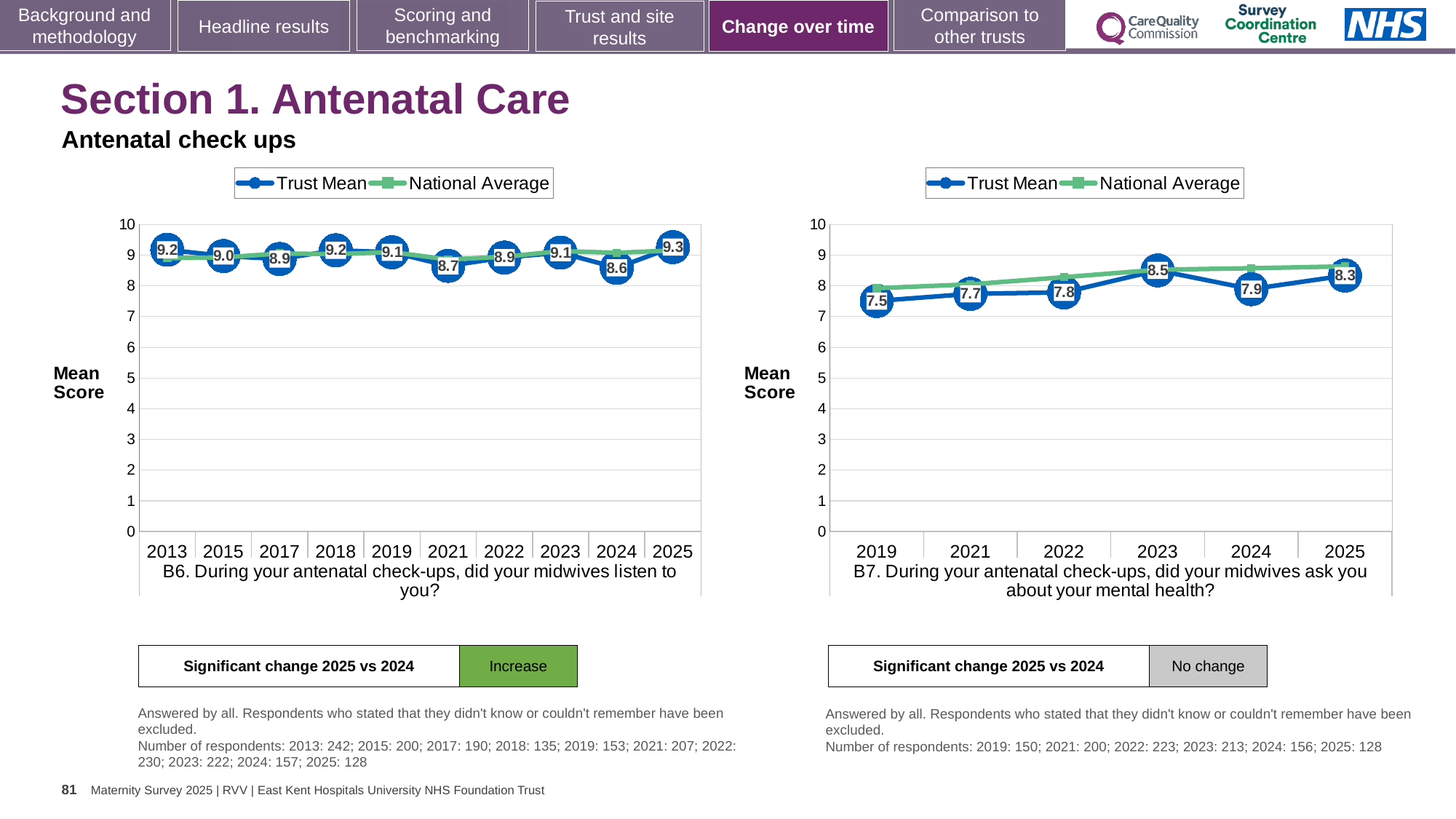
In the B6 chart (left), what is the difference between the Trust Mean in 2025 and in 2024? 0.7 In the B6 chart (left), which year has the lowest Trust Mean? 2024 In the B6 chart (left), how many years are shown on the x axis? 10 How many series does the legend of the B7 chart (right) list? 2 In the B7 chart (right), is the Trust Mean for 2019 greater or less than 8? less In the B6 chart (left), what is the Trust Mean for 2024? 8.6 In the B7 chart (right), is the Trust Mean higher in 2023 or in 2024? 2023 In the B7 chart (right), what is the Trust Mean for 2019? 7.5 In the B7 chart (right), which year has the highest Trust Mean? 2023 In the B6 chart (left), what is the Trust Mean for 2025? 9.3 In the B7 chart (right), which year has the lowest Trust Mean? 2019 What kind of chart is the B6 chart (left)? Line chart